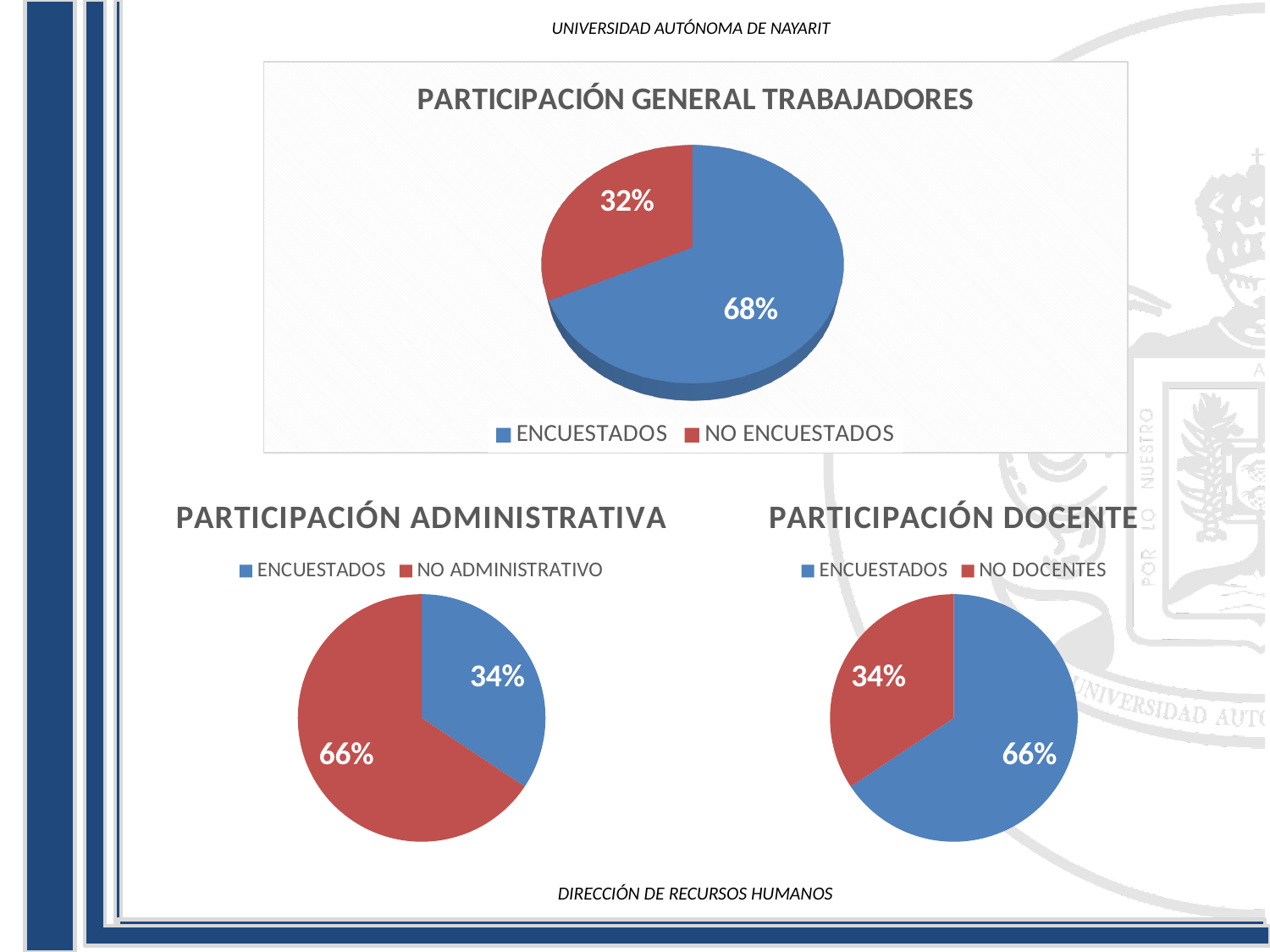
In the PARTICIPACIÓN ADMINISTRATIVA chart, what share of the pie is ENCUESTADOS? 34% What kind of chart is the PARTICIPACIÓN DOCENTE chart? Pie chart In the PARTICIPACIÓN DOCENTE chart, what share of the pie is ENCUESTADOS? 66% In the PARTICIPACIÓN ADMINISTRATIVA chart, what share of the pie is NO ADMINISTRATIVO? 66% In the PARTICIPACIÓN GENERAL TRABAJADORES chart, which slice is the largest? ENCUESTADOS How many entries does the legend of the PARTICIPACIÓN ADMINISTRATIVA chart list? 2 In the PARTICIPACIÓN DOCENTE chart, which is larger, ENCUESTADOS or NO DOCENTES? ENCUESTADOS In the PARTICIPACIÓN GENERAL TRABAJADORES chart, what is the difference between the ENCUESTADOS and NO ENCUESTADOS shares? 36% In the PARTICIPACIÓN ADMINISTRATIVA chart, which slice is the smallest? ENCUESTADOS